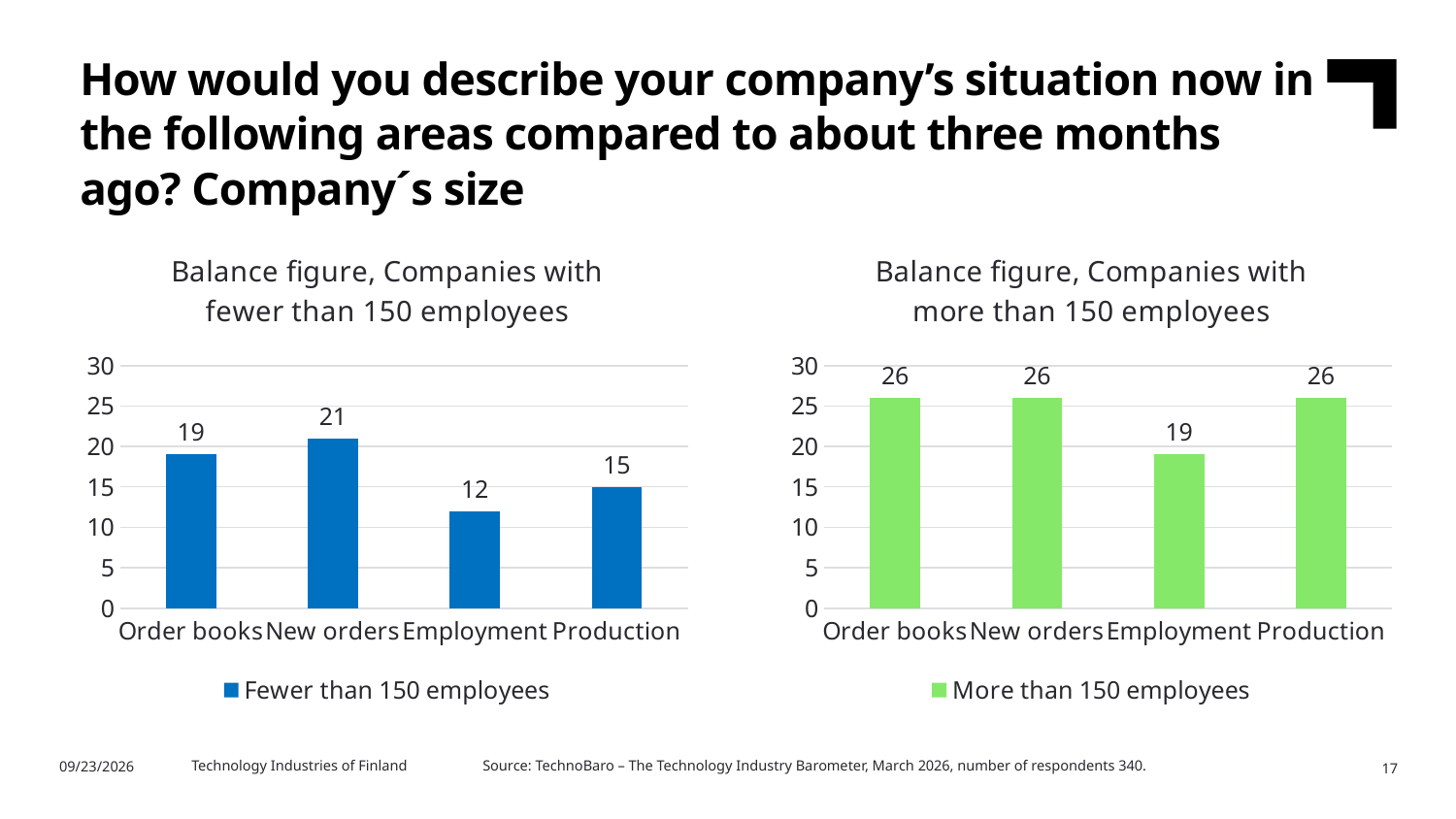
What legend entry is shown under the chart 'Balance figure, Companies with more than 150 employees'? More than 150 employees In the chart 'Balance figure, Companies with fewer than 150 employees', which category has the highest value? New orders What kind of chart is 'Balance figure, Companies with fewer than 150 employees'? Bar chart In the chart 'Balance figure, Companies with fewer than 150 employees', is the value for Order books greater or less than 15? greater In the chart 'Balance figure, Companies with fewer than 150 employees', what is the value for New orders? 21 How many categories are shown in the chart 'Balance figure, Companies with more than 150 employees'? 4 In the chart 'Balance figure, Companies with fewer than 150 employees', which category has the lowest value? Employment In the chart 'Balance figure, Companies with fewer than 150 employees', what is the difference between the values for New orders and Employment? 9 In the chart 'Balance figure, Companies with more than 150 employees', what is the value for Employment? 19 In the chart 'Balance figure, Companies with more than 150 employees', which category has the lowest value? Employment Which is larger: the value for Production in the left chart (fewer than 150 employees) or the value for Production in the right chart (more than 150 employees)? More than 150 employees (26) In the chart 'Balance figure, Companies with more than 150 employees', what is the difference between the values for Order books and Employment? 7